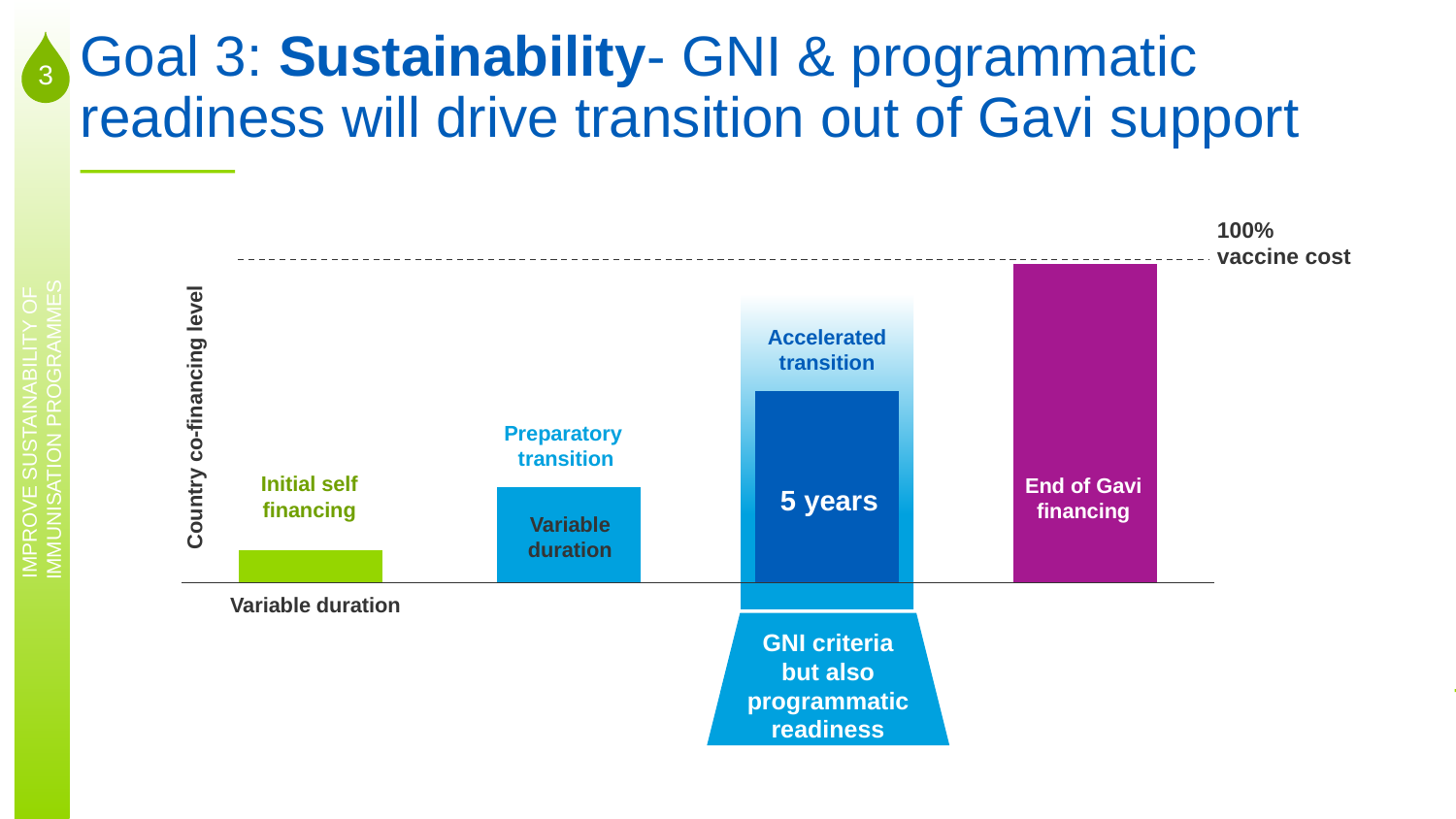
Which has a higher co-financing level, Preparatory transition or Accelerated transition? Accelerated transition Which phase has the lowest country co-financing level? Initial self financing What is the label of the vertical axis? Country co-financing level What is the duration of the Accelerated transition phase? 5 years What is the duration of the Preparatory transition phase? Variable duration What kind of chart is shown on the slide? bar chart Do the bars rise or fall from left to right along the x axis? rise What does the dashed horizontal line at the top of the chart represent? 100% vaccine cost Which has a lower co-financing level, Initial self financing or Preparatory transition? Initial self financing How many bars (phases) are shown in the chart? 4 Which phase has the highest country co-financing level? End of Gavi financing